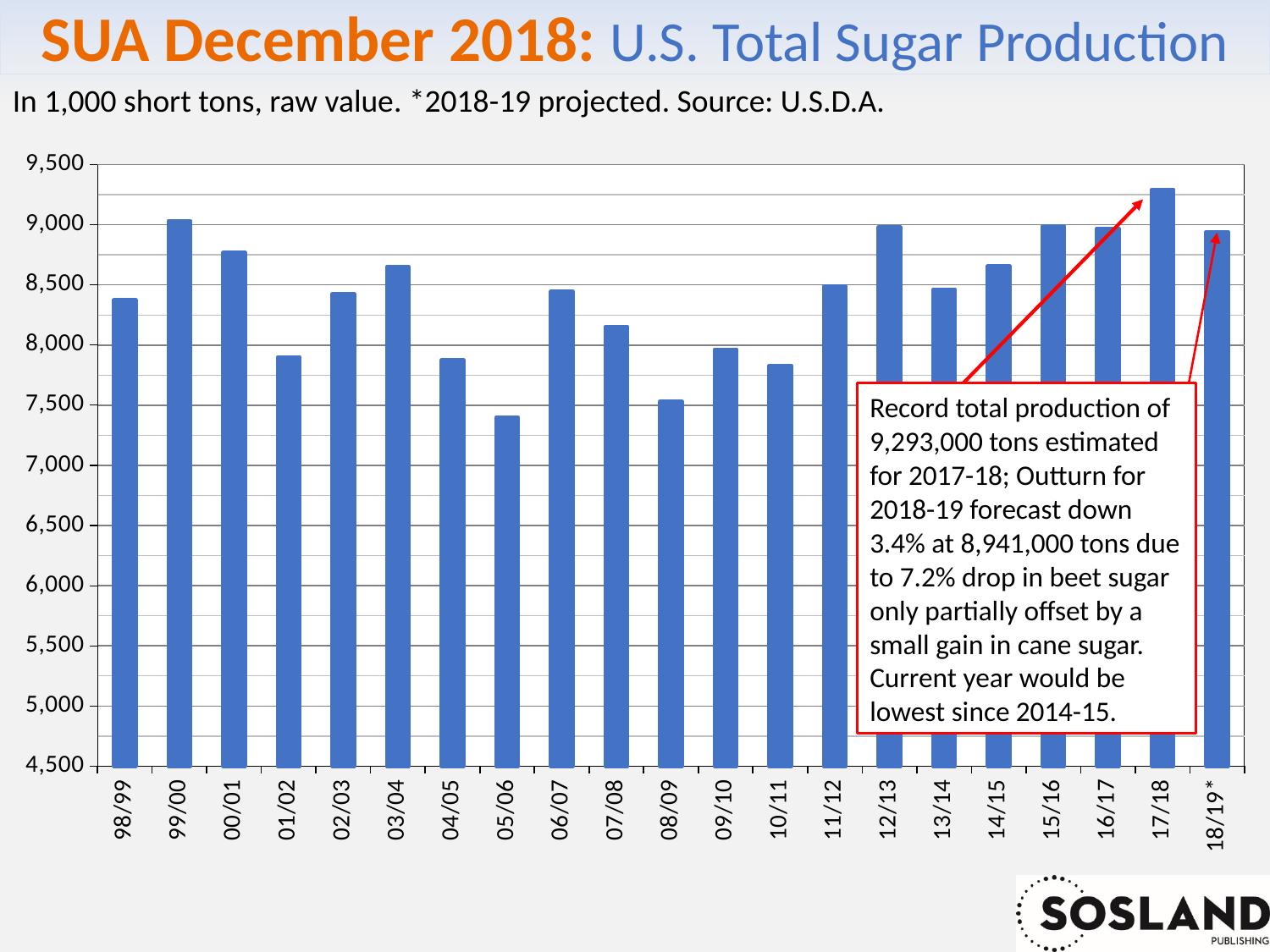
Which crop year has the highest total sugar production on the chart? 17/18 Is the value for 03/04 greater or less than 8,500? greater How many crop years (bars) are plotted on the chart? 21 According to the text box on the slide, what is the forecast total production for 2018-19? 8,941,000 tons Which crop year has the lowest total sugar production on the chart? 05/06 Do the values rise or fall from 99/00 to 01/02? fall Which is larger, the value for 99/00 or the value for 00/01? 99/00 Is the value for 10/11 greater or less than 8,000? less What kind of chart is shown on the slide? bar chart Is the value for 05/06 greater or less than 7,500? less According to the text box on the slide, what was the record total production estimated for 2017-18? 9,293,000 tons What is the lowest value shown on the vertical axis of the chart? 4,500